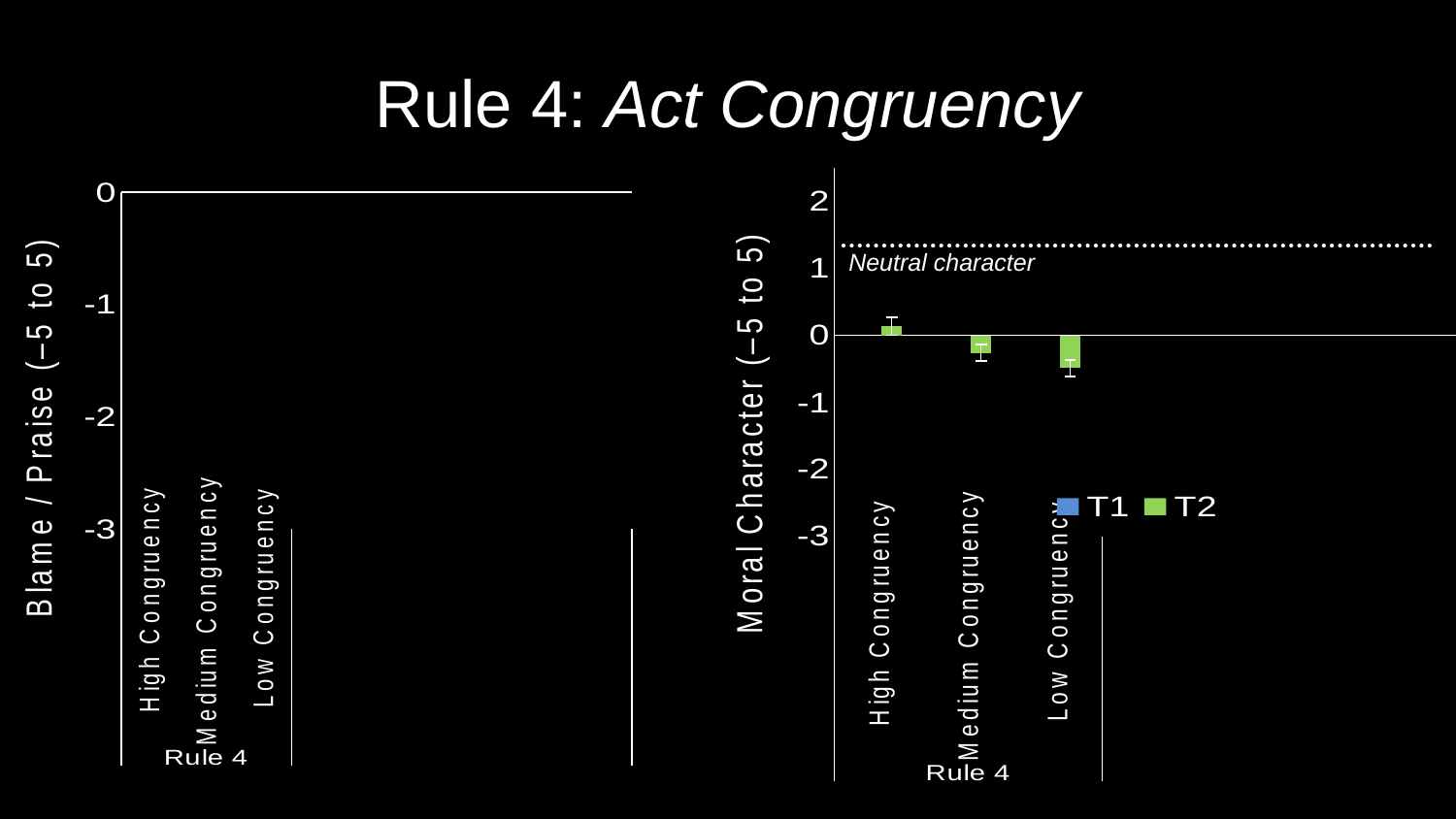
In the Moral Character chart, is the T2 value for Medium Congruency greater or less than 1? less In the Moral Character chart, do the T2 values rise or fall moving from High Congruency to Low Congruency? fall In the Moral Character chart, how many congruency categories are shown on the x axis? 3 In the Moral Character chart, what label is given to the dotted horizontal line? Neutral character In the Moral Character chart, which colour represents the T2 series in the legend? green What kind of chart is the right-hand chart (Moral Character)? bar chart In the Moral Character chart, is the T2 value for High Congruency greater or less than 0? greater In the Moral Character chart, which has the larger T2 value: High Congruency or Low Congruency? High Congruency In the Moral Character chart, which category has the highest T2 value? High Congruency In the Moral Character chart, which category has the lowest T2 value? Low Congruency In the Moral Character chart, how many series does the legend list? 2 In the Moral Character chart, is the T2 value for Low Congruency greater or less than 0? less